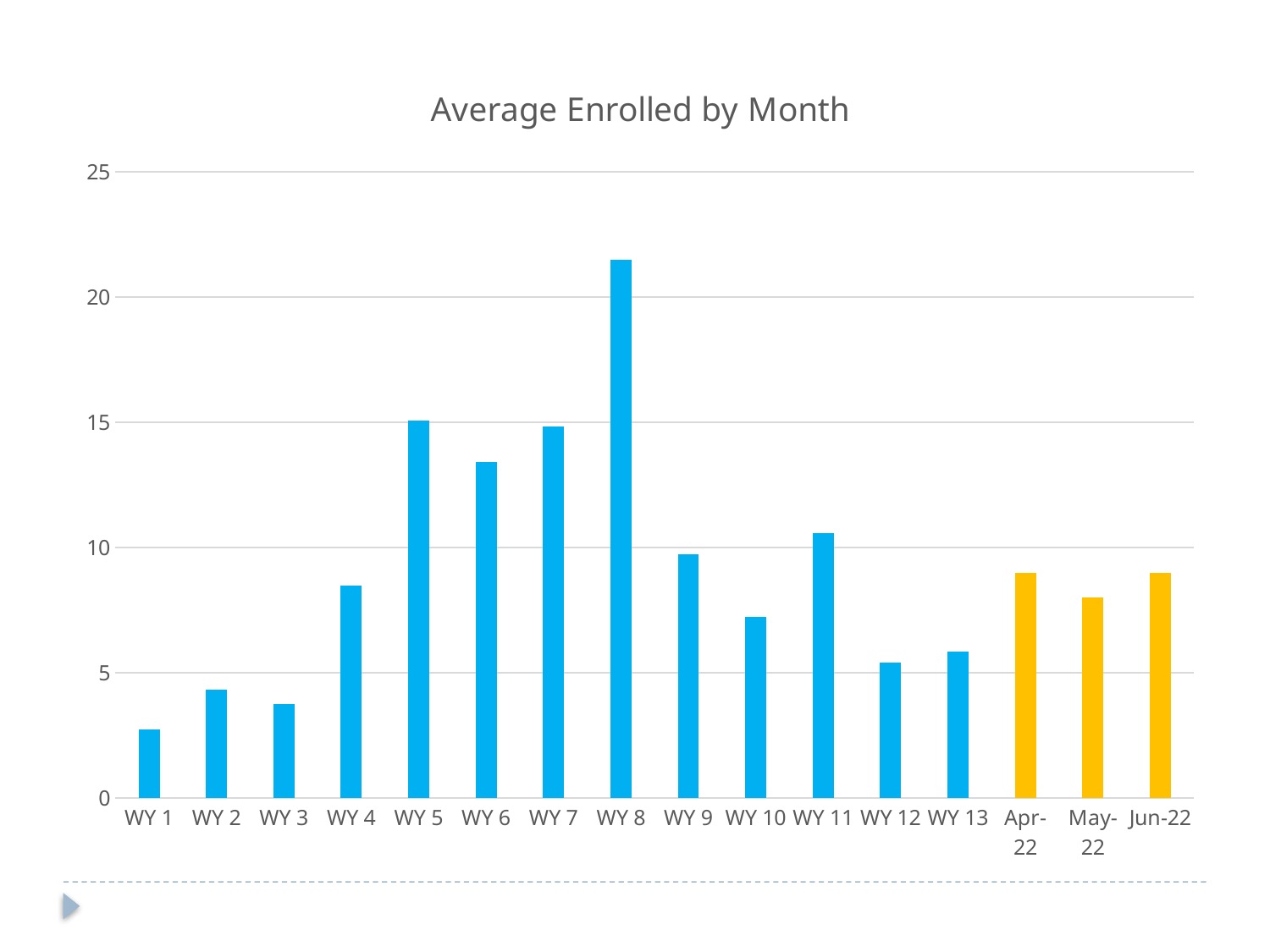
Is the value for WY 6 greater or less than 15? less Which is larger, the value for WY 9 or the value for WY 11? WY 11 From WY 8 to WY 10, do the values rise or fall? fall Is the value for WY 1 greater or less than 5? less Is the value for WY 10 greater or less than 10? less What is the title of the chart? Average Enrolled by Month Which is larger, the value for WY 5 or the value for WY 6? WY 5 How many categories are plotted along the x axis? 16 Which category has the lowest value? WY 1 Which category has the highest value? WY 8 What kind of chart is shown on the slide? bar chart